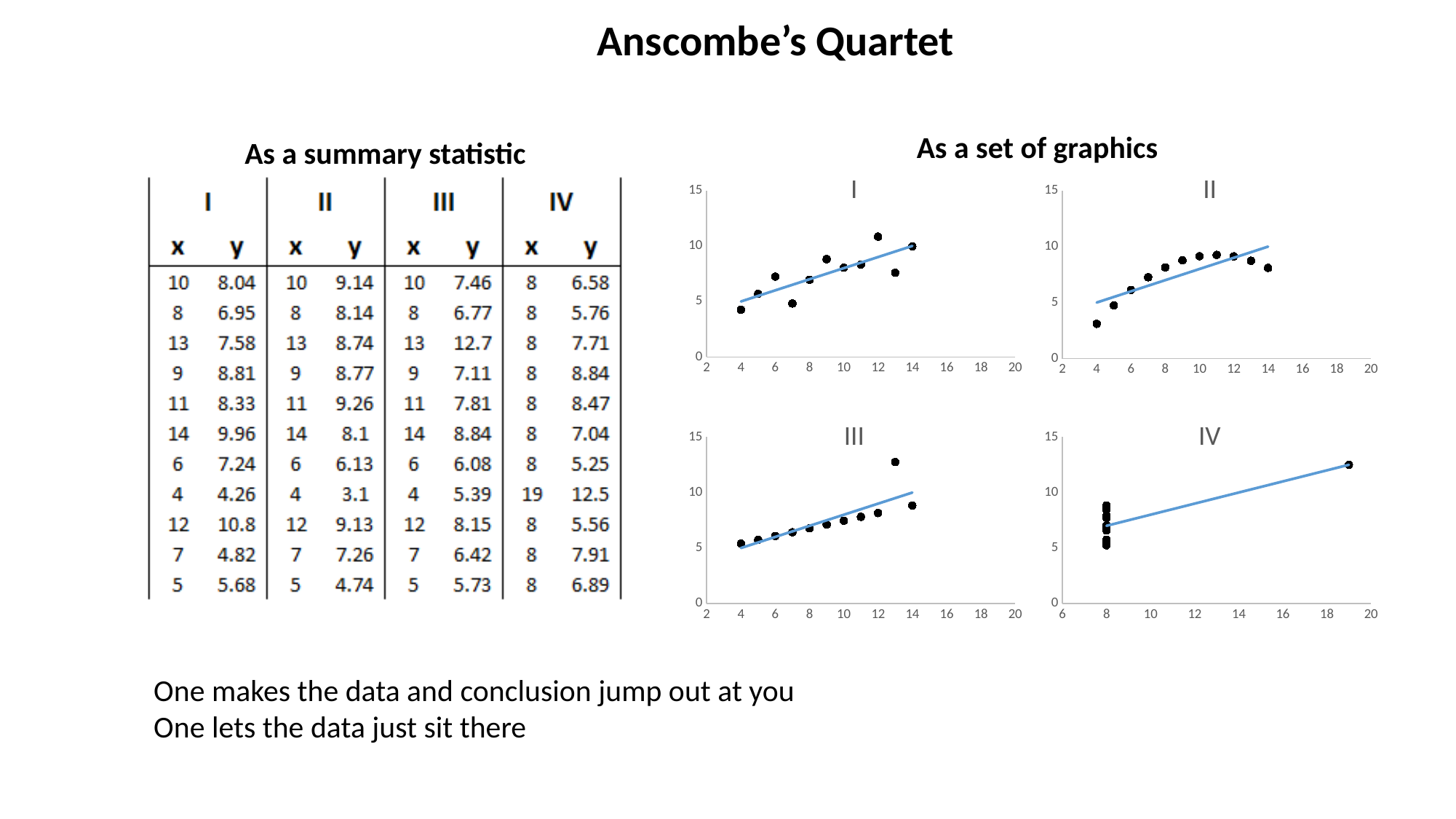
What kind of charts are the four charts labelled I, II, III and IV? Scatter charts In chart II, at which x value is the lowest y value plotted? 4 In chart II, is the y value of the point at x = 4 greater or less than 5? less In chart I, is the y value of the point at x = 4 greater or less than 5? less In chart III, at which x value is the highest y value plotted? 13 In chart I, which point has the larger y value: the one at x = 13 or the one at x = 14? x = 14 In chart III, how many data points are plotted? 11 In chart I, how many data points are plotted? 11 In chart IV, is the y value of the rightmost point greater or less than 10? greater In chart I, does the fitted line rise or fall as x increases? rise